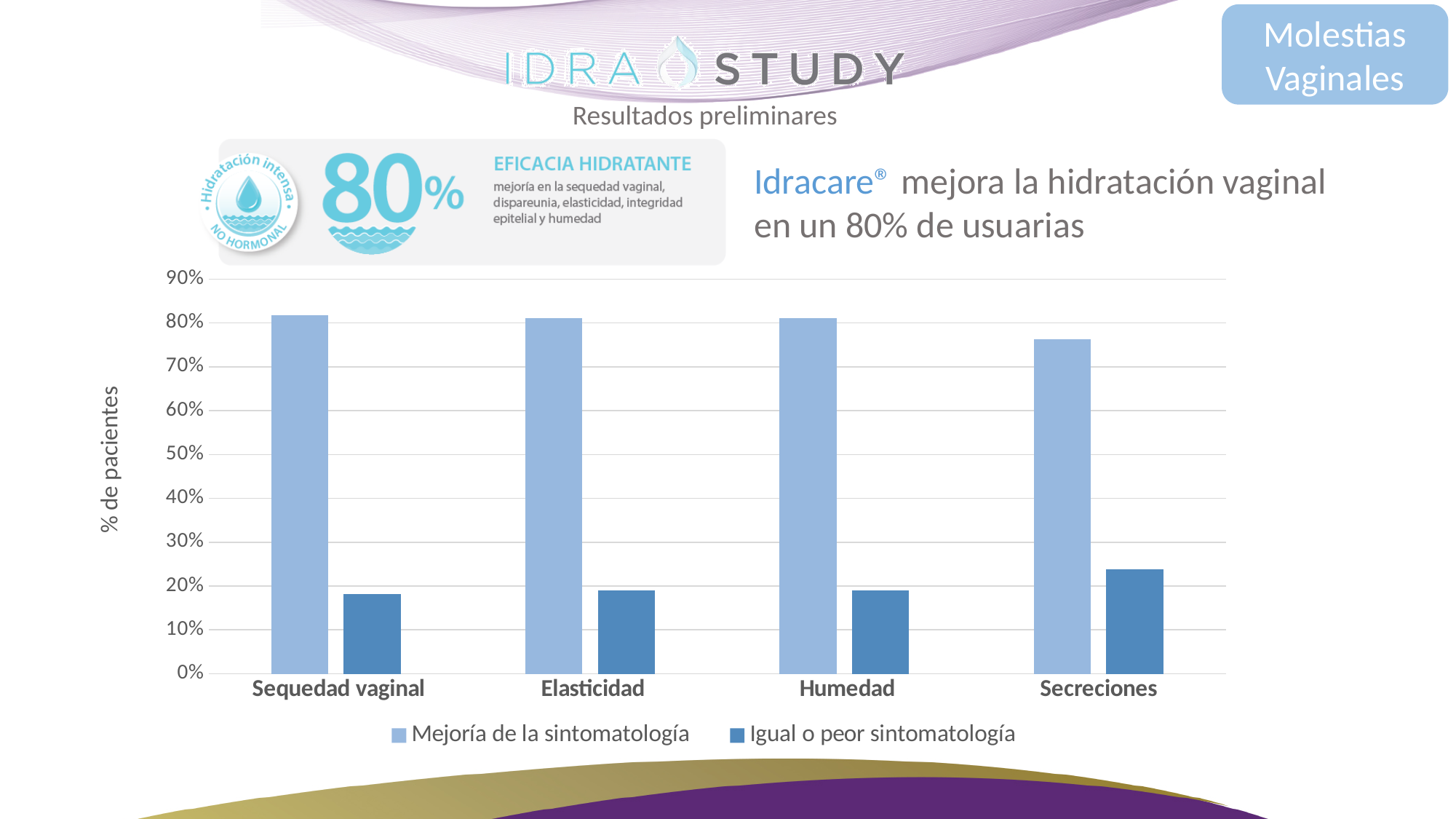
Which is larger: Mejoría de la sintomatología for Sequedad vaginal or for Secreciones? Sequedad vaginal Which category has the lowest value for Mejoría de la sintomatología? Secreciones What kind of chart is shown on the slide? bar chart What is the label of the y axis of the chart? % de pacientes Is the value for Mejoría de la sintomatología in Humedad greater or less than 70%? greater Which series is shown in the darker blue colour in the chart? Igual o peor sintomatología Is the value for Mejoría de la sintomatología in Secreciones greater or less than 80%? less Which is larger: Igual o peor sintomatología for Secreciones or for Elasticidad? Secreciones Is the value for Igual o peor sintomatología in Secreciones greater or less than 20%? greater Which category has the highest value for Igual o peor sintomatología? Secreciones How many categories are shown on the x axis of the chart? 4 How many series does the chart legend list? 2